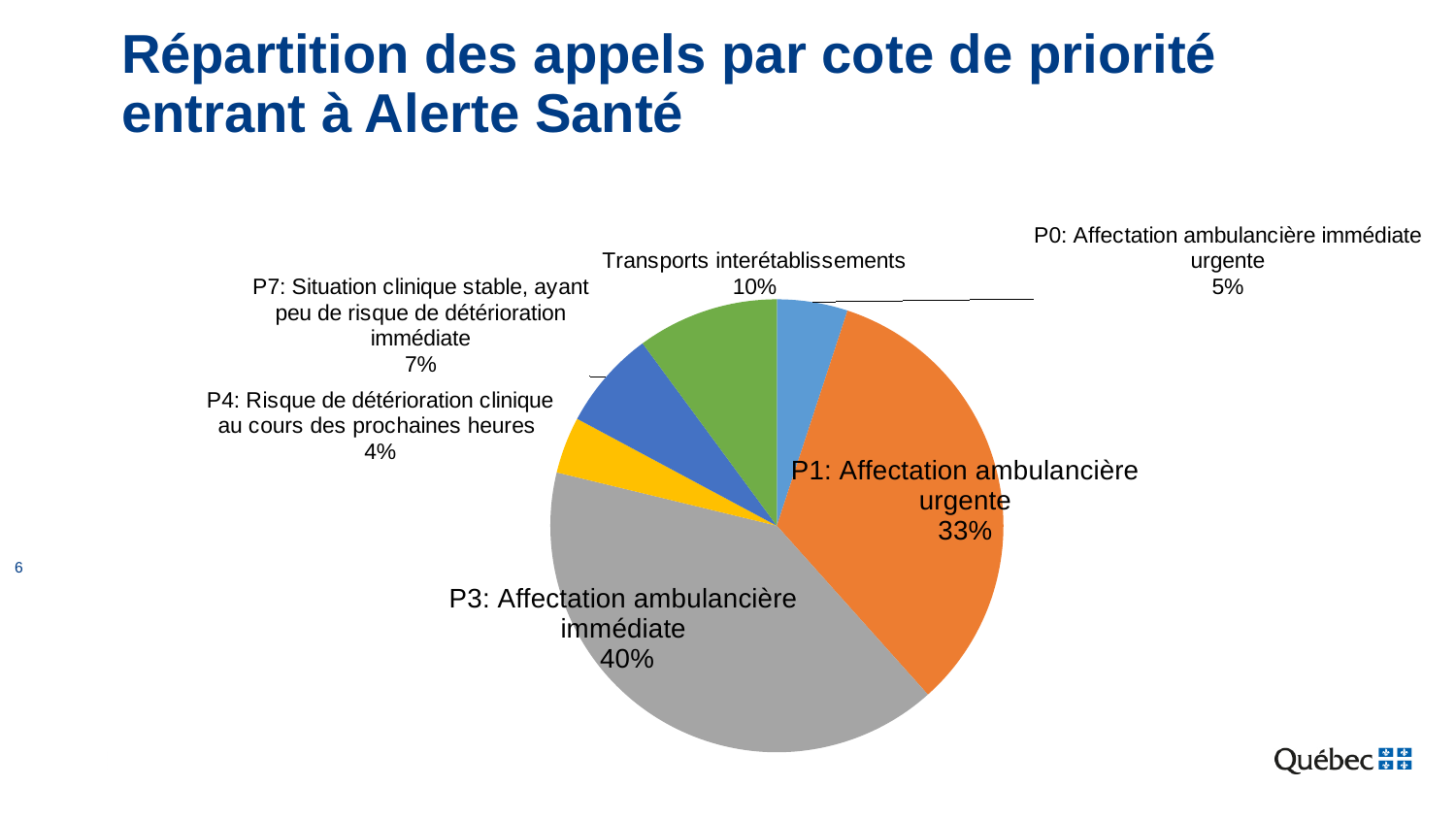
What share of calls is P1: Affectation ambulancière urgente? 33% What is the difference in percentage points between P3: Affectation ambulancière immédiate and P1: Affectation ambulancière urgente? 7 Which category has the largest share of the pie? P3: Affectation ambulancière immédiate What share of calls is Transports interétablissements? 10% What share of calls is P4: Risque de détérioration clinique au cours des prochaines heures? 4% What is the title of the slide containing the chart? Répartition des appels par cote de priorité entrant à Alerte Santé What share of calls is P0: Affectation ambulancière immédiate urgente? 5% Which category has the smallest share of the pie? P4: Risque de détérioration clinique au cours des prochaines heures What type of chart is shown on the slide? pie chart Which is larger, the share for Transports interétablissements or the share for P7: Situation clinique stable, ayant peu de risque de détérioration immédiate? Transports interétablissements How many slices does the pie chart have? 6 What share of calls is P3: Affectation ambulancière immédiate? 40%